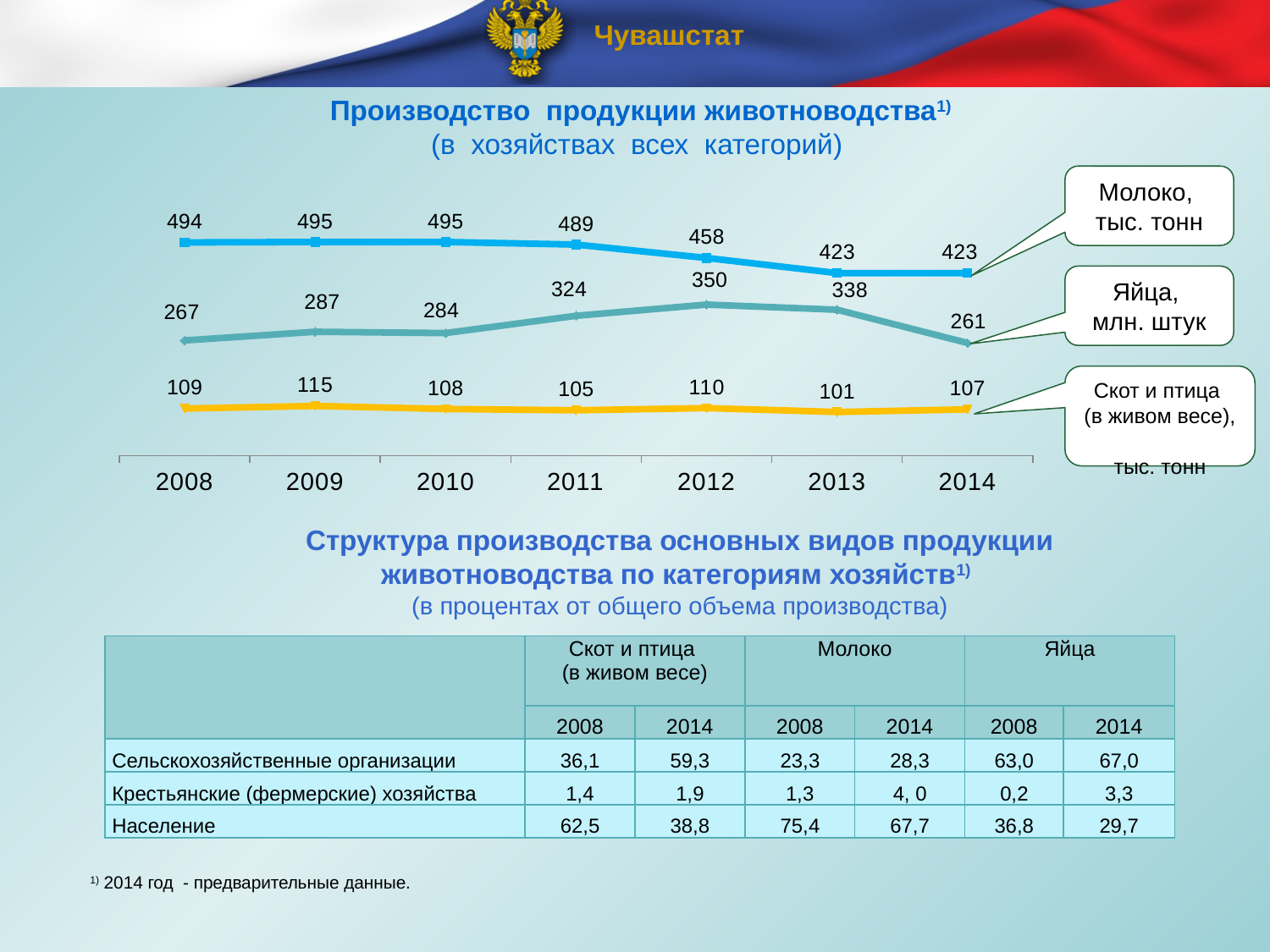
What is the value for Яйца in 2011? 324 In which year is the value for Яйца highest? 2012 In which year is the value for Скот и птица (в живом весе) lowest? 2013 How many data series are plotted in the chart? 3 What is the value for Молоко in 2012? 458 What is the value for Скот и птица (в живом весе) in 2013? 101 In what units is the Яйца series measured, according to the chart label? млн. штук How many years are shown on the x axis of the chart? 7 Does the value for Молоко rise or fall from 2010 to 2014? fall What kind of chart is shown on the slide? line chart By how much did the value for Молоко fall from 2008 to 2014? 71 Which year has the larger value for Яйца, 2009 or 2010? 2009